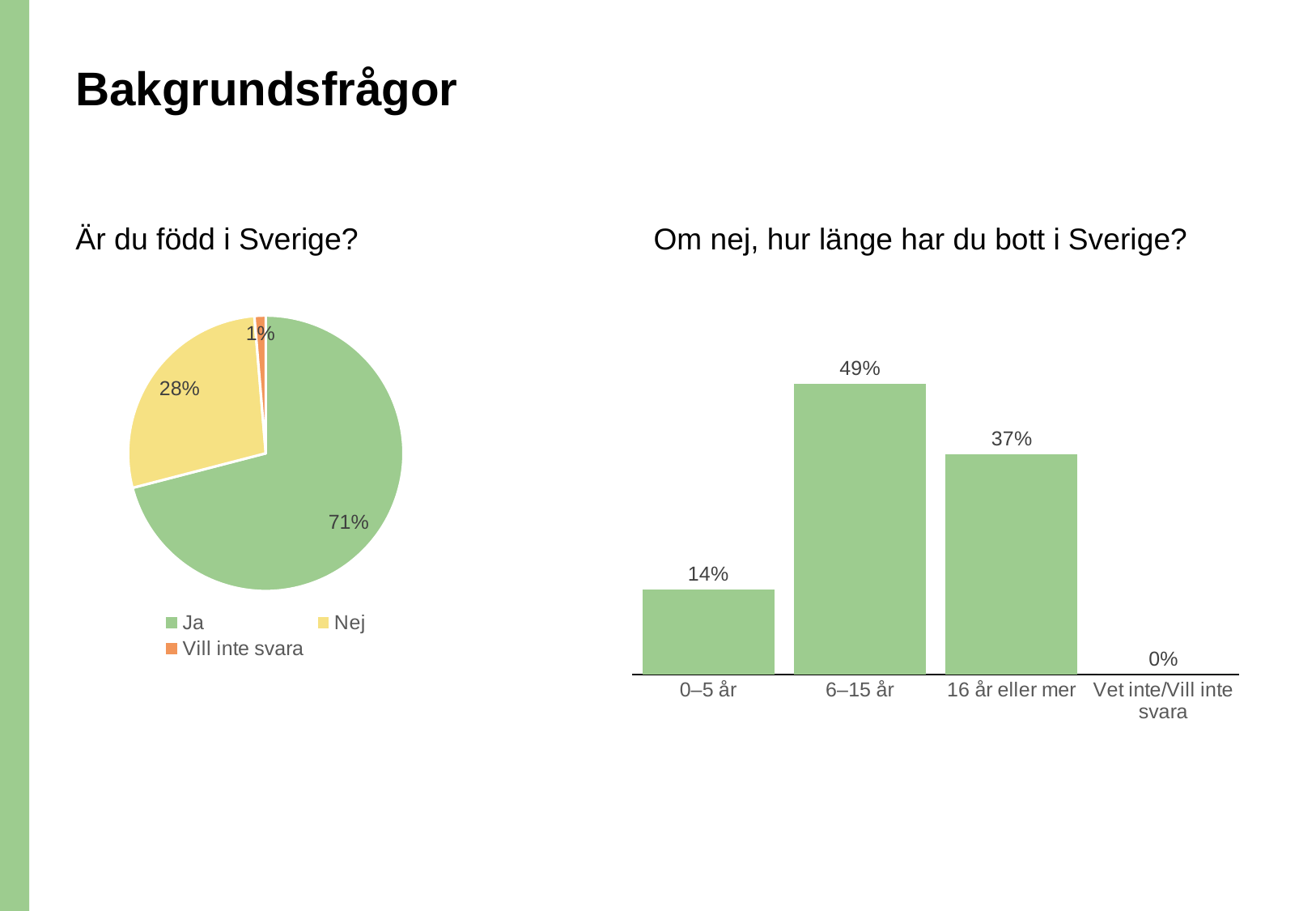
In the chart 'Om nej, hur länge har du bott i Sverige?', what is the difference between the values for '6–15 år' and '16 år eller mer'? 12% In the chart 'Om nej, hur länge har du bott i Sverige?', what is the value for '6–15 år'? 49% In the pie chart 'Är du född i Sverige?', how many categories does the legend list? 3 In the pie chart 'Är du född i Sverige?', what is the value for 'Vill inte svara'? 1% What kind of chart is the chart on the right of the slide? Bar chart In the chart 'Om nej, hur länge har du bott i Sverige?', which category has the highest value? 6–15 år In the pie chart 'Är du född i Sverige?', what share of respondents answered 'Nej'? 28% In the chart 'Om nej, hur länge har du bott i Sverige?', what is the value for '0–5 år'? 14% In the chart 'Om nej, hur länge har du bott i Sverige?', which category has the lowest value? Vet inte/Vill inte svara In the pie chart 'Är du född i Sverige?', which category has the largest slice? Ja In the pie chart 'Är du född i Sverige?', what share of respondents answered 'Ja'? 71% What kind of chart is the chart on the left of the slide? Pie chart